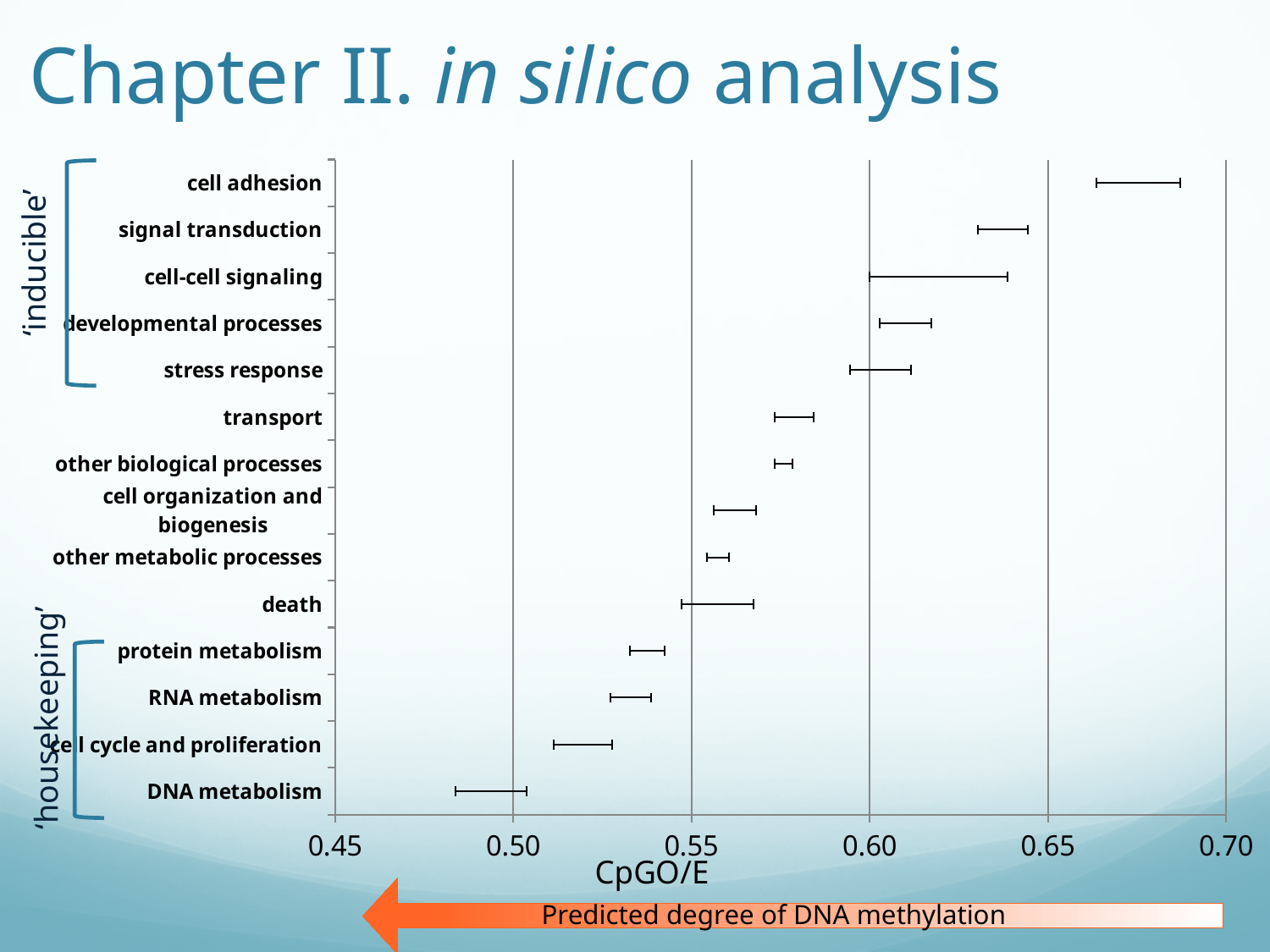
How many categories are plotted on the chart? 14 Which two groups of categories are bracketed on the left of the chart? 'inducible' and 'housekeeping' Which category has the lowest CpGO/E value? DNA metabolism Is the value for DNA metabolism greater or less than 0.55? less Which has a higher CpGO/E value, cell-cell signaling or death? cell-cell signaling Is the value for cell adhesion greater or less than 0.65? greater Is the value for transport greater or less than 0.55? greater Which has a higher CpGO/E value, transport or RNA metabolism? transport What is the label of the horizontal axis? CpGO/E Which category has the highest CpGO/E value? cell adhesion